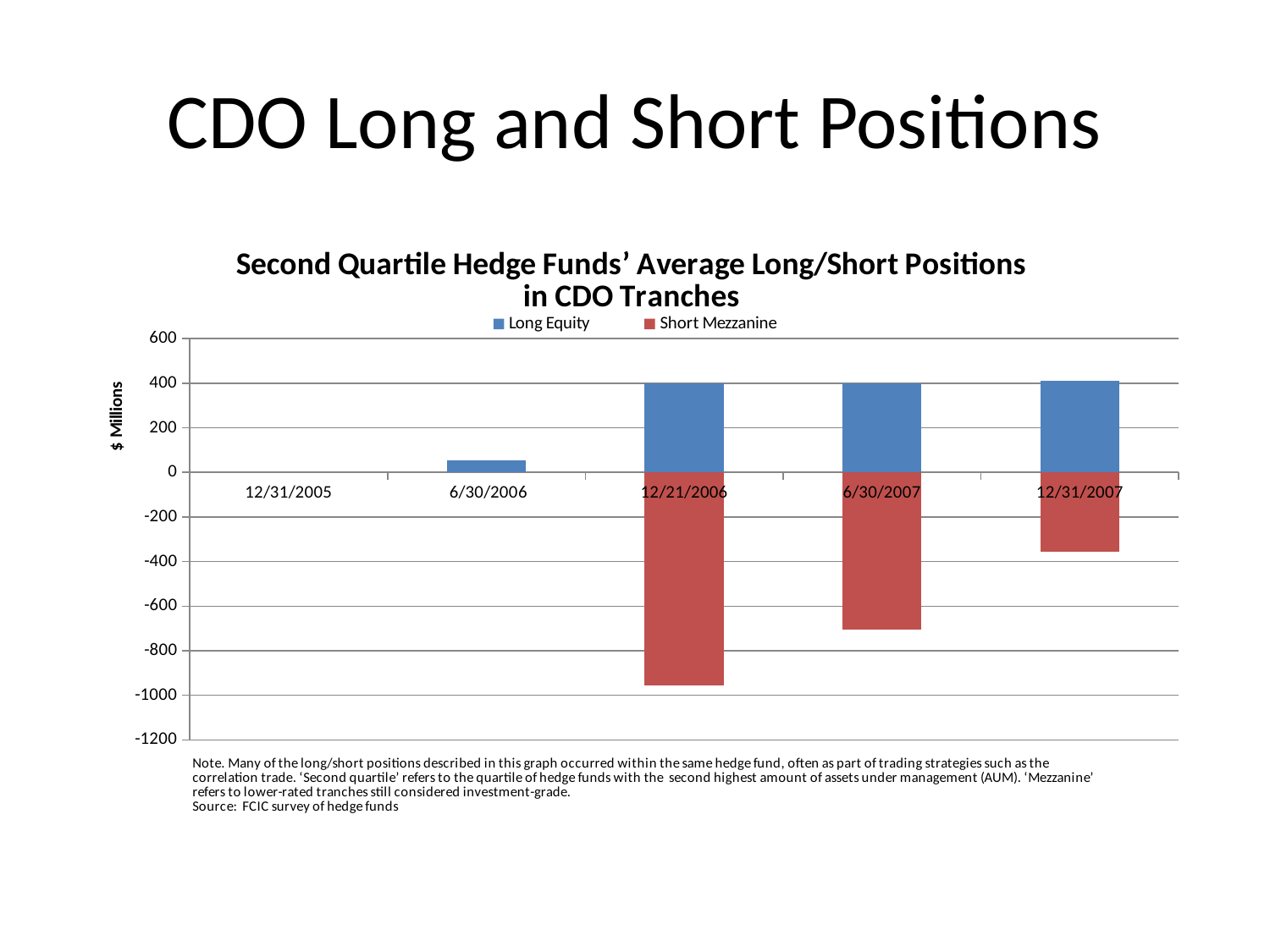
From 12/21/2006 to 12/31/2007, does the Short Mezzanine value rise or fall? rise What kind of chart is shown on the slide? Bar chart Is the Long Equity value for 6/30/2006 greater or less than 200? less Which date has the larger Long Equity value, 6/30/2006 or 12/21/2006? 12/21/2006 On which date is the Short Mezzanine position lowest (most negative)? 12/21/2006 Which series is shown in red? Short Mezzanine Is the Short Mezzanine value for 6/30/2007 greater or less than -600? less Is the Short Mezzanine value for 12/21/2006 greater or less than -800? less What is the label on the vertical axis? $ Millions How many dates are shown on the x axis? 5 How many series does the legend list? 2